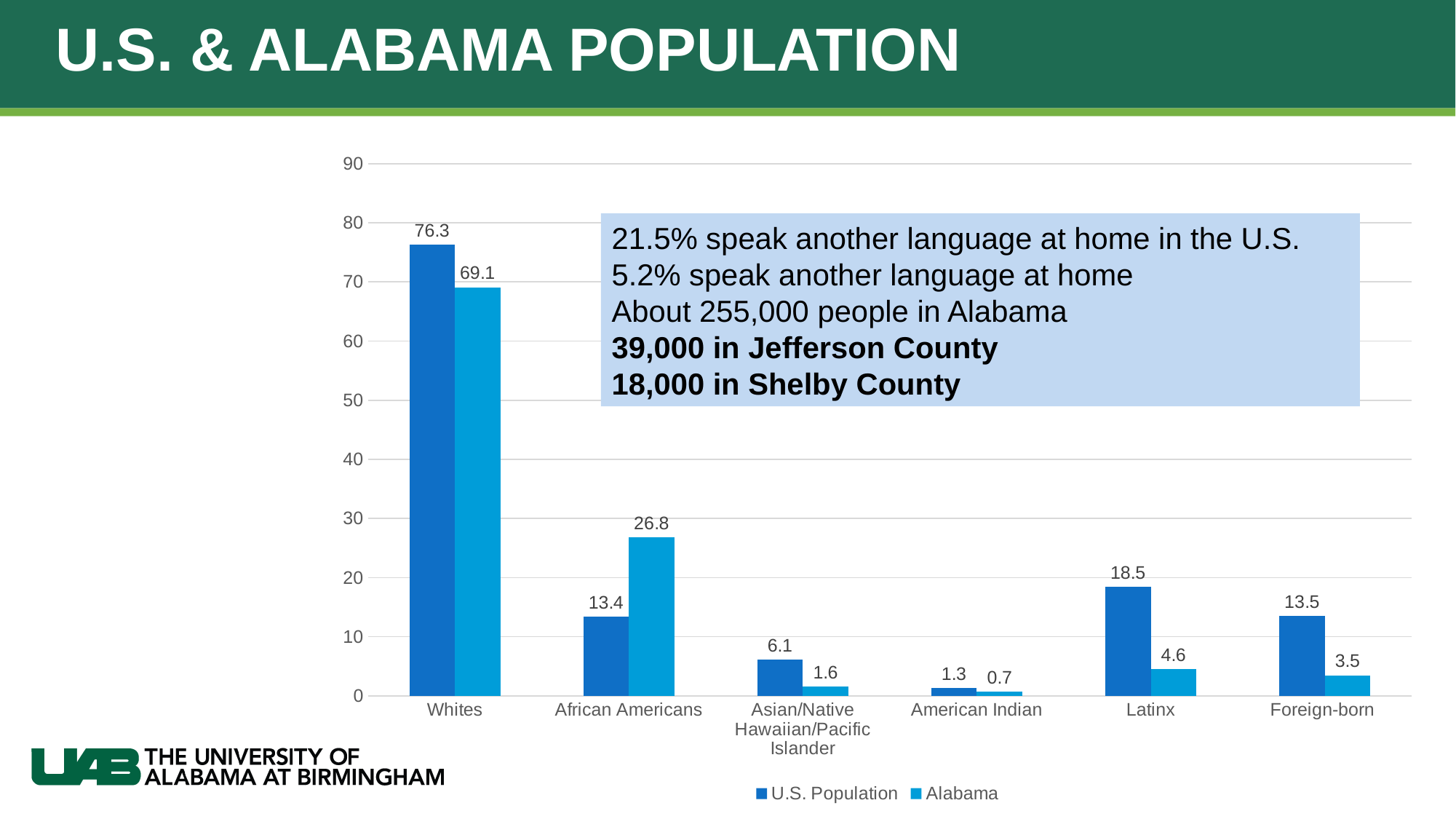
How many series does the legend list? 2 What is the U.S. Population value for Whites? 76.3 Which is larger for Asian/Native Hawaiian/Pacific Islander: the U.S. Population value or the Alabama value? U.S. Population What kind of chart is shown on the slide? Bar chart What is the difference between the Alabama and U.S. Population values for African Americans? 13.4 Which category has the lowest Alabama value? American Indian What is the Alabama value for Latinx? 4.6 What is the difference between the U.S. Population and Alabama values for Foreign-born? 10 What is the Alabama value for African Americans? 26.8 Which category has the highest U.S. Population value? Whites What are the two series named in the legend? U.S. Population and Alabama How many categories are shown on the x axis? 6